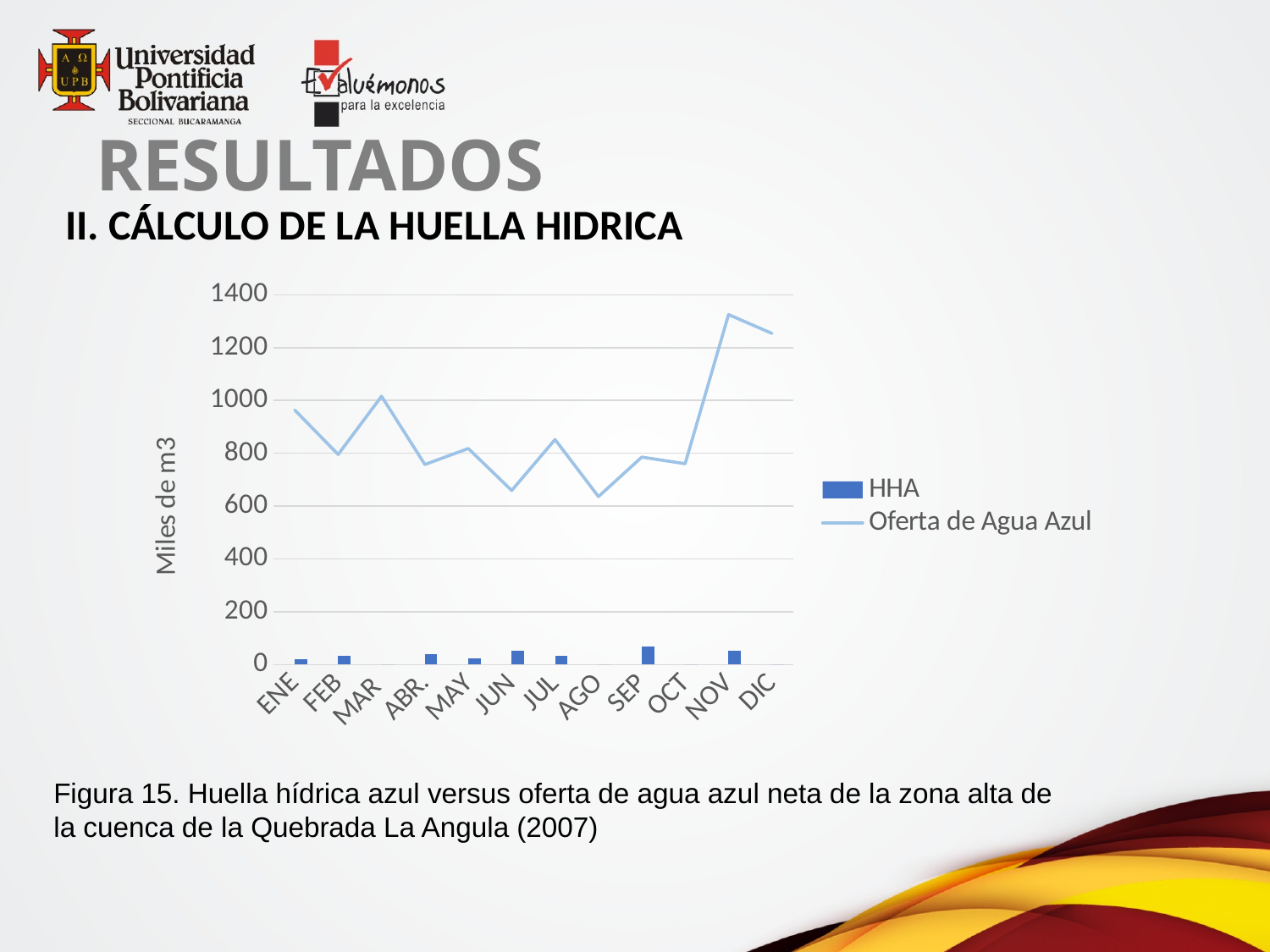
How many series does the legend list? 2 What kind of chart is this? A combined bar and line chart How many months are shown on the x axis? 12 Is the Oferta de Agua Azul value for NOV greater or less than 1200? greater Which month has the highest value for Oferta de Agua Azul? NOV Which is larger, the Oferta de Agua Azul value for MAR or for ABR? MAR Does the Oferta de Agua Azul line rise or fall from OCT to NOV? rise Is the Oferta de Agua Azul value for JUN greater or less than 800? less Is the Oferta de Agua Azul value for AGO greater or less than 800? less Which month has the tallest HHA bar? SEP What is the title of the vertical axis? Miles de m3